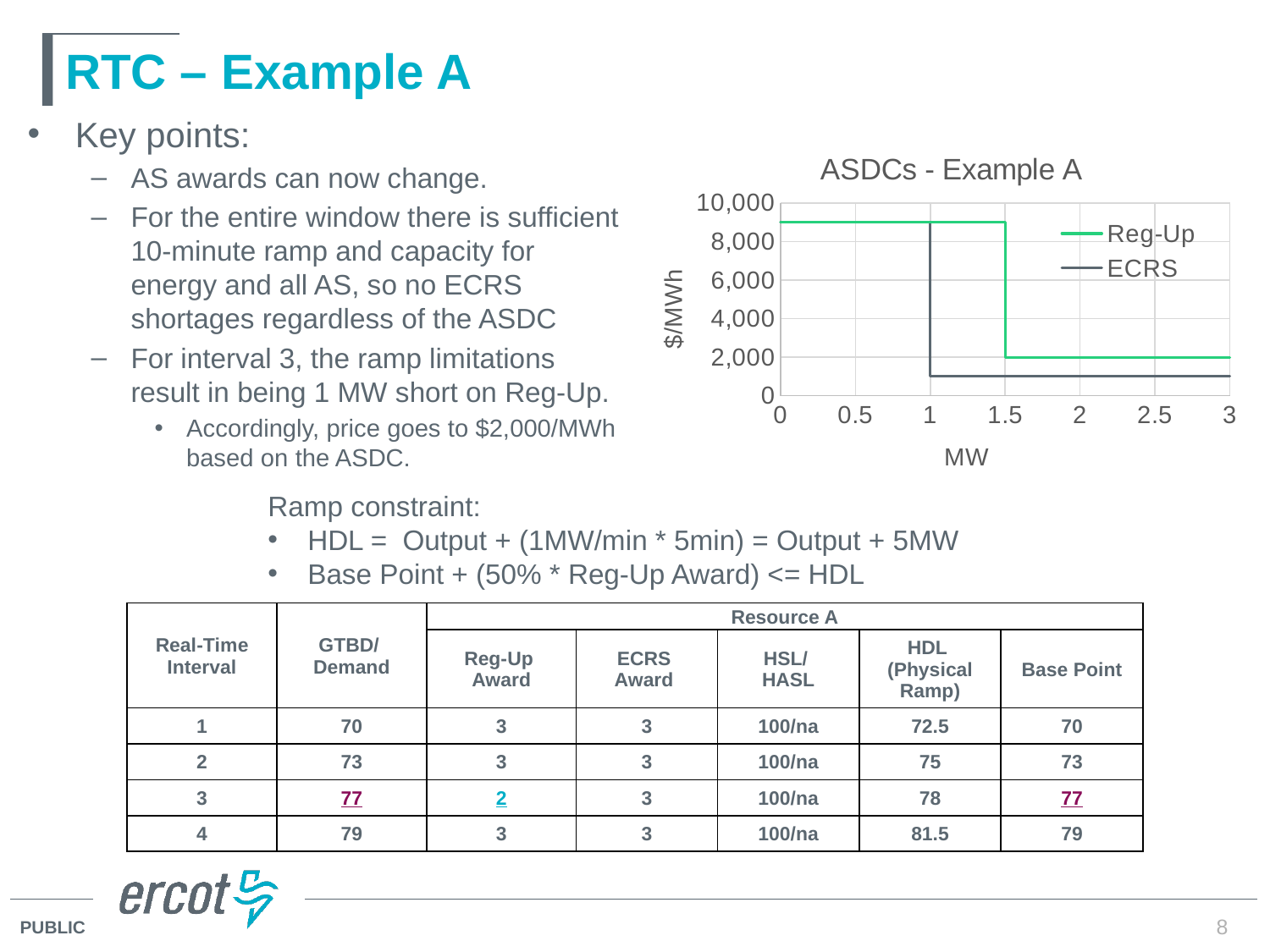
What kind of chart is shown on the slide? line chart Is the ECRS value at 2 MW greater or less than 2,000? less At 2 MW, which series has the higher value, Reg-Up or ECRS? Reg-Up What is the title of the chart on the slide? ASDCs - Example A What is the Reg-Up value in $/MWh at 2.5 MW? 2,000 Do the Reg-Up values rise or fall as MW increases along the x axis? fall Which series is drawn in green in the chart? Reg-Up What is the label of the chart's x axis? MW Is the ECRS value at 0.5 MW greater or less than 8,000? greater At 1.25 MW, which series has the higher value, Reg-Up or ECRS? Reg-Up How many series does the chart's legend list? 2 Is the Reg-Up value at 0.5 MW greater or less than 8,000? greater